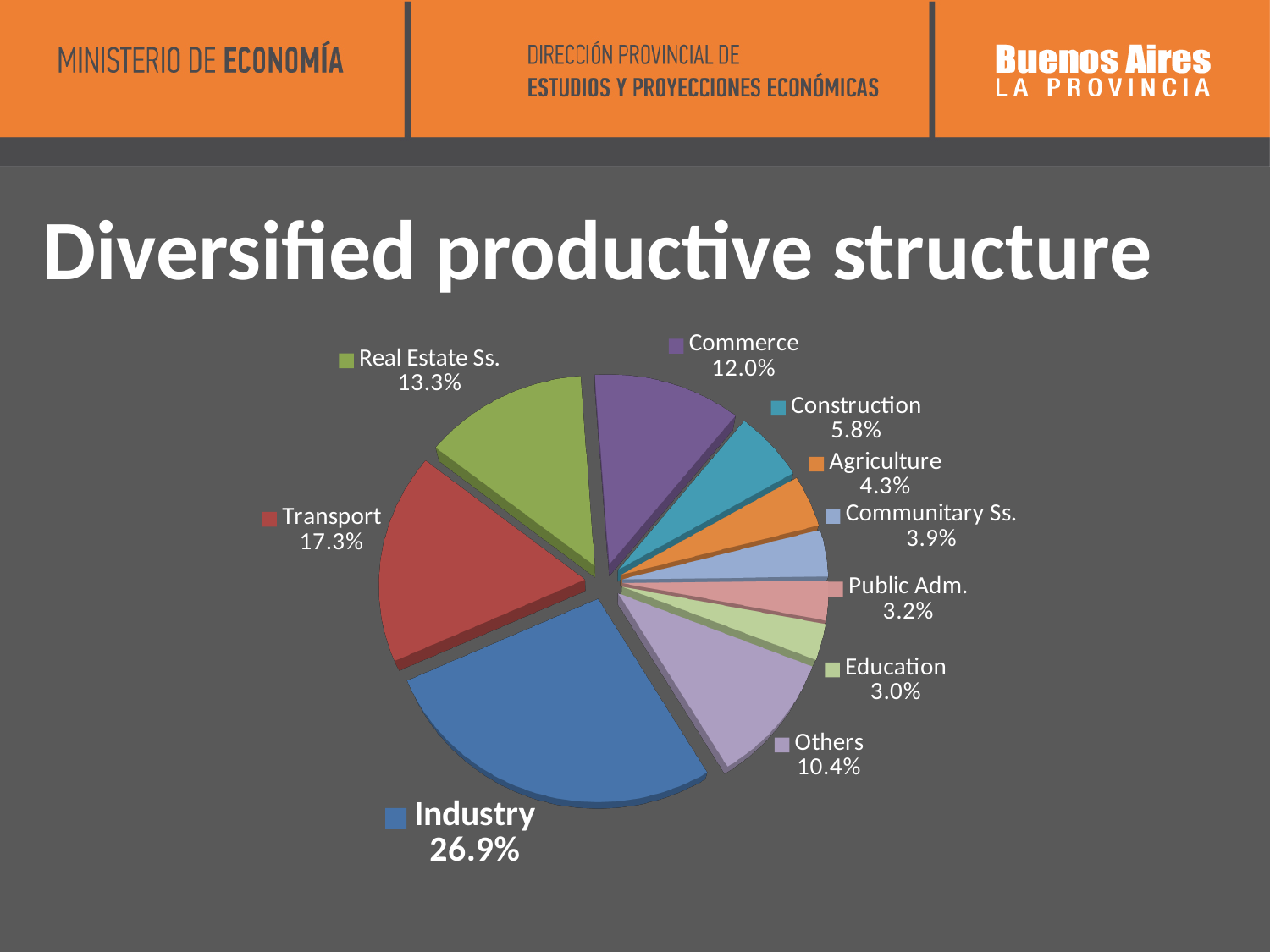
What share of the pie does Industry hold? 26.9% Which category has the smallest slice of the pie? Education How many slices does the pie chart have? 10 What is the value shown for Transport? 17.3% Which is larger, Agriculture or Communitary Ss.? Agriculture Which category has the largest slice of the pie? Industry What is the difference between the Industry and Transport shares? 9.6% What is the value shown for Real Estate Ss.? 13.3% What is the value shown for Construction? 5.8% What kind of chart is shown on the slide? pie chart What is the title of the slide containing the pie chart? Diversified productive structure What is the difference between the Commerce and Others shares? 1.6%